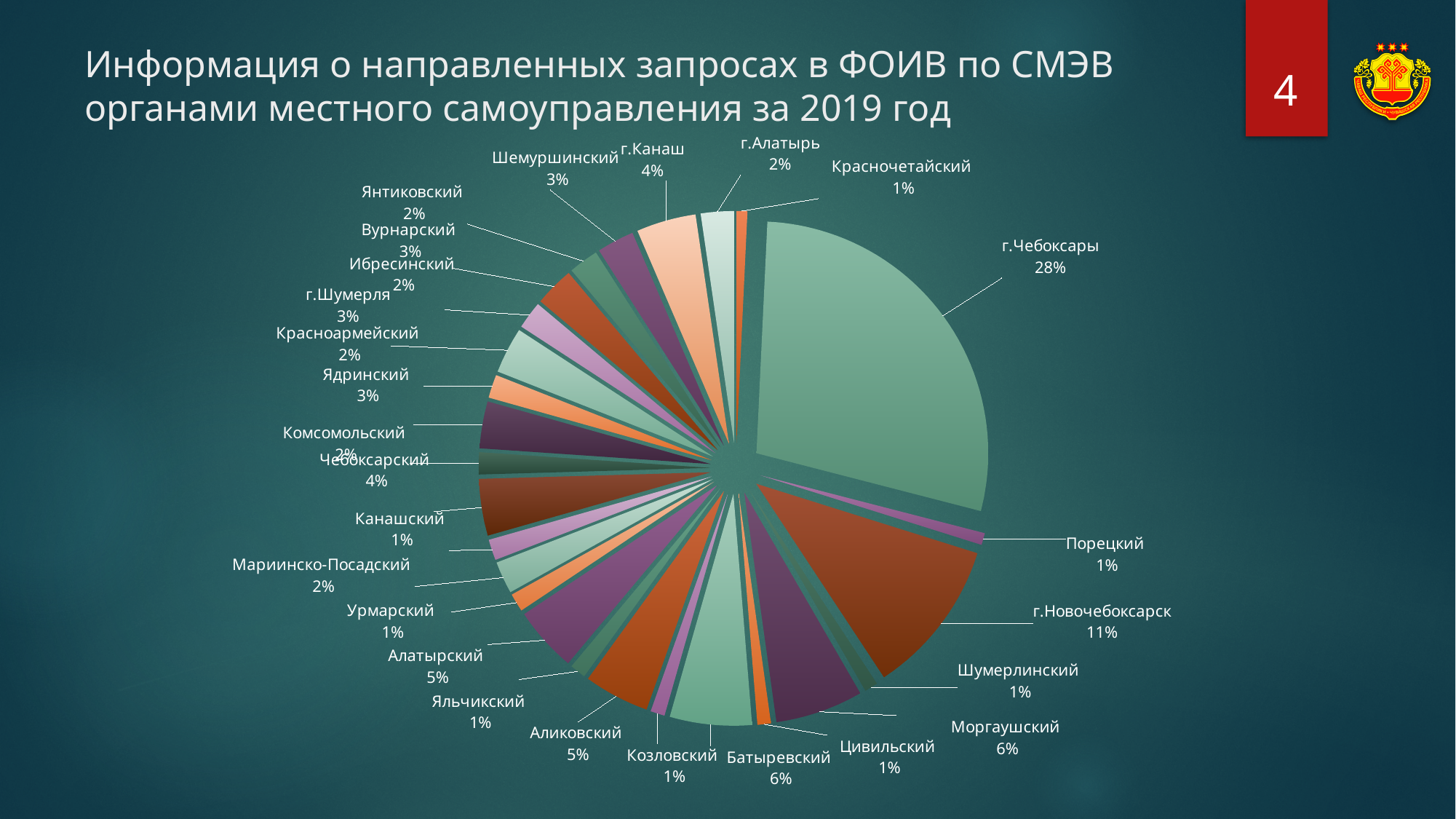
What year does the chart title say the data refers to? 2019 Which is larger, the value for г.Новочебоксарск or the value for Моргаушский? г.Новочебоксарск What is the value shown for Моргаушский? 6% What is the value shown for г.Новочебоксарск? 11% What is the value shown for г.Канаш? 4% What is the value shown for Ядринский? 3% What is the difference in percentage points between г.Чебоксары and г.Новочебоксарск? 17 Which category has the largest slice of the pie? г.Чебоксары What type of chart is shown on the slide? Pie chart What share of the pie does г.Чебоксары have? 28% What is the value shown for Алатырский? 5% How many categories are shown in the pie chart? 26